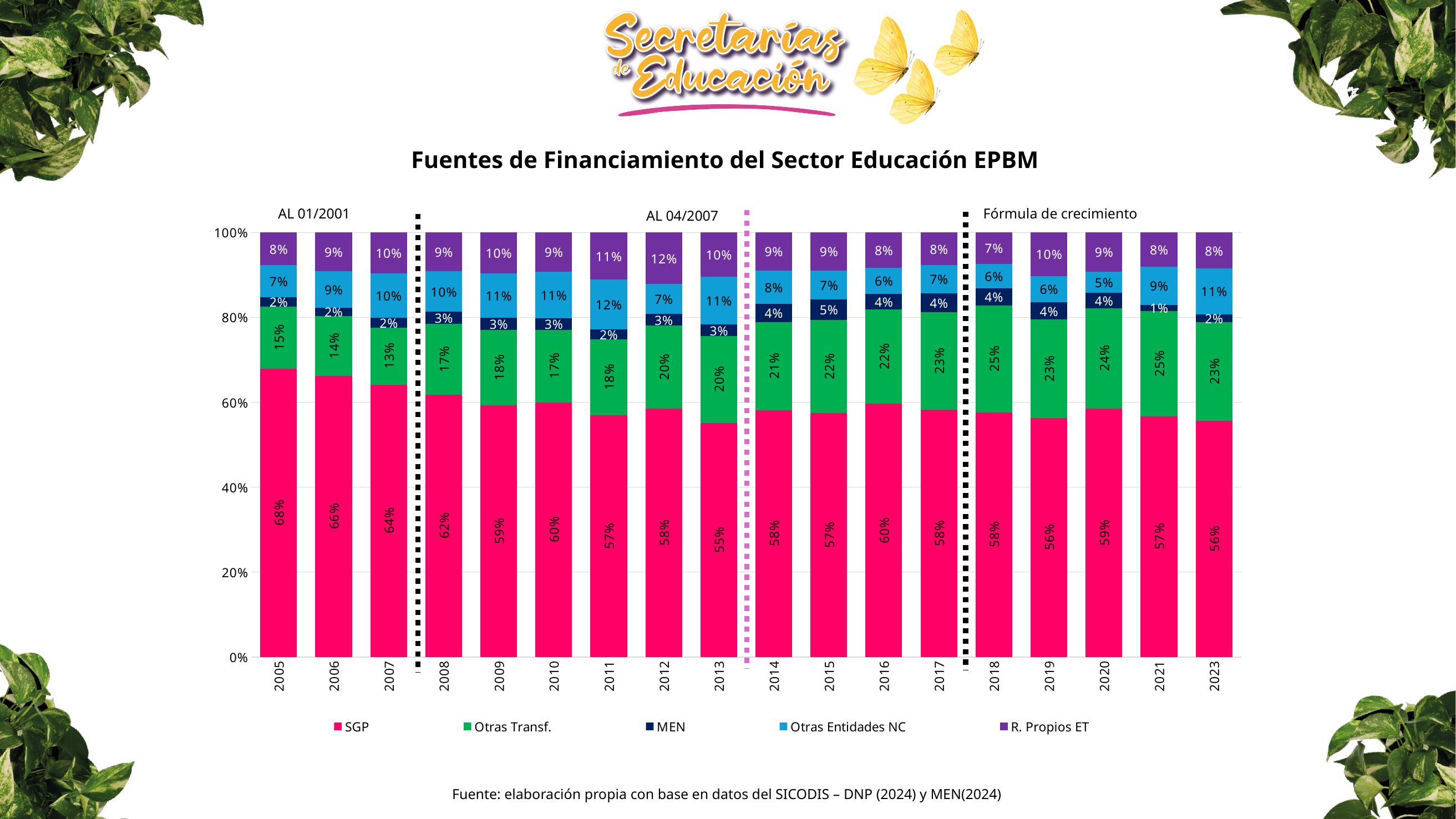
What is the R. Propios ET share in 2012? 12% What is the difference between the SGP share in 2005 and in 2023? 12% What is the title of the chart? Fuentes de Financiamiento del Sector Educación EPBM What is the SGP share in 2005? 68% What is the Otras Transf. share in 2018? 25% How many series does the legend list? 5 How many years (bars) are shown on the x axis? 18 In which year is the MEN share the lowest? 2021 What type of chart is shown on the slide? Stacked bar chart In which year is the SGP share the lowest? 2013 Which is larger, the Otras Entidades NC share in 2011 or in 2012? 2011 In which year is the SGP share the highest? 2005